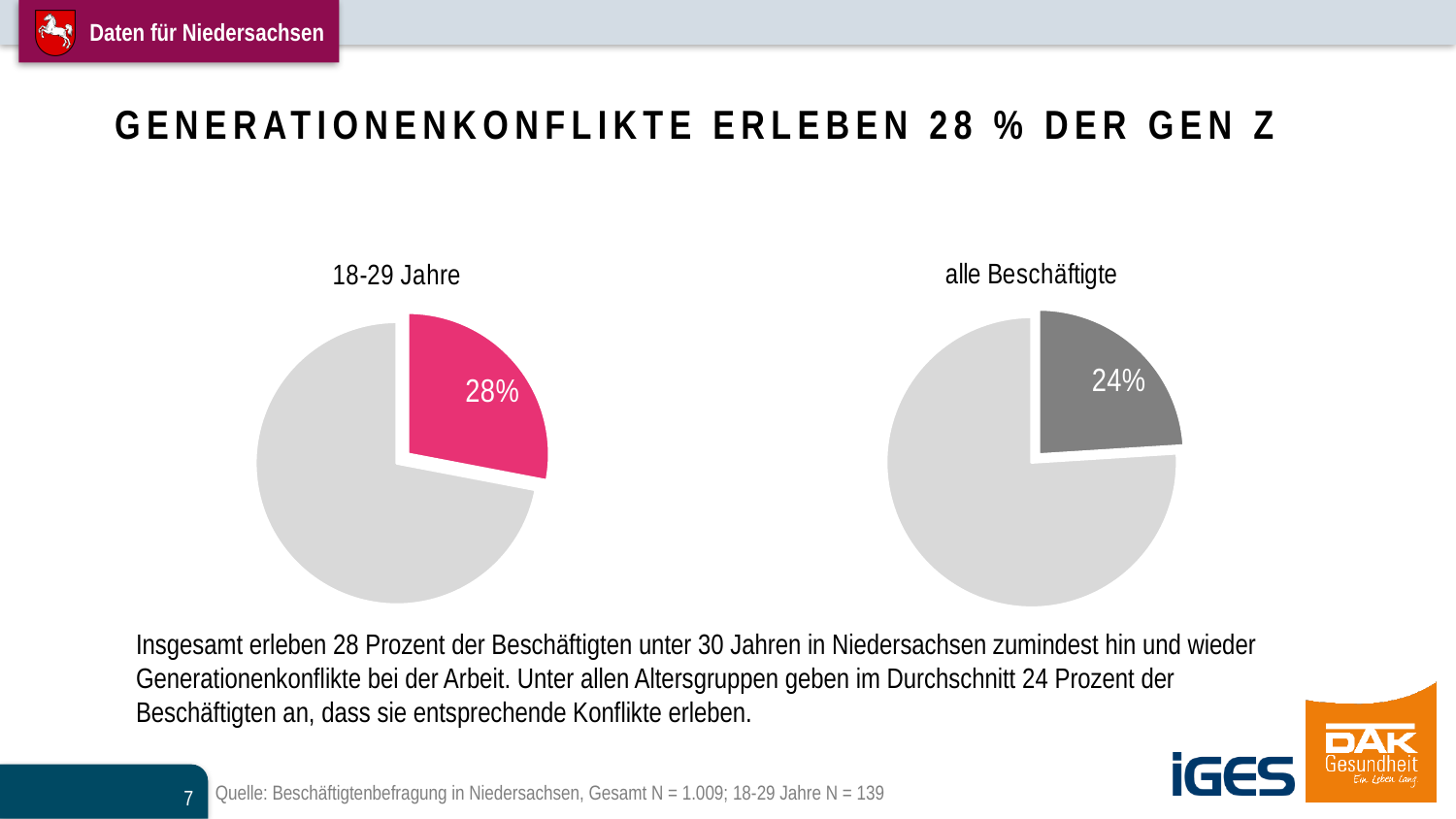
In the 'alle Beschäftigte' pie chart, what percentage is shown on the highlighted slice? 24% What type of chart is used for 'alle Beschäftigte'? Pie chart In the '18-29 Jahre' pie chart, is the highlighted slice greater or less than 25%? greater In the 'alle Beschäftigte' pie chart, is the highlighted slice greater or less than 25%? less What type of chart is used for '18-29 Jahre'? Pie chart How many pie charts are shown on the slide? 2 What is the difference between the highlighted share in the '18-29 Jahre' chart and the highlighted share in the 'alle Beschäftigte' chart? 4 percentage points In the '18-29 Jahre' pie chart, what share of the pie is not highlighted? 72% Which chart shows the larger highlighted share, '18-29 Jahre' or 'alle Beschäftigte'? 18-29 Jahre What colour is the highlighted slice in the 'alle Beschäftigte' pie chart? Dark grey In the '18-29 Jahre' pie chart, what percentage is shown on the highlighted slice? 28% What colour is the highlighted slice in the '18-29 Jahre' pie chart? Pink